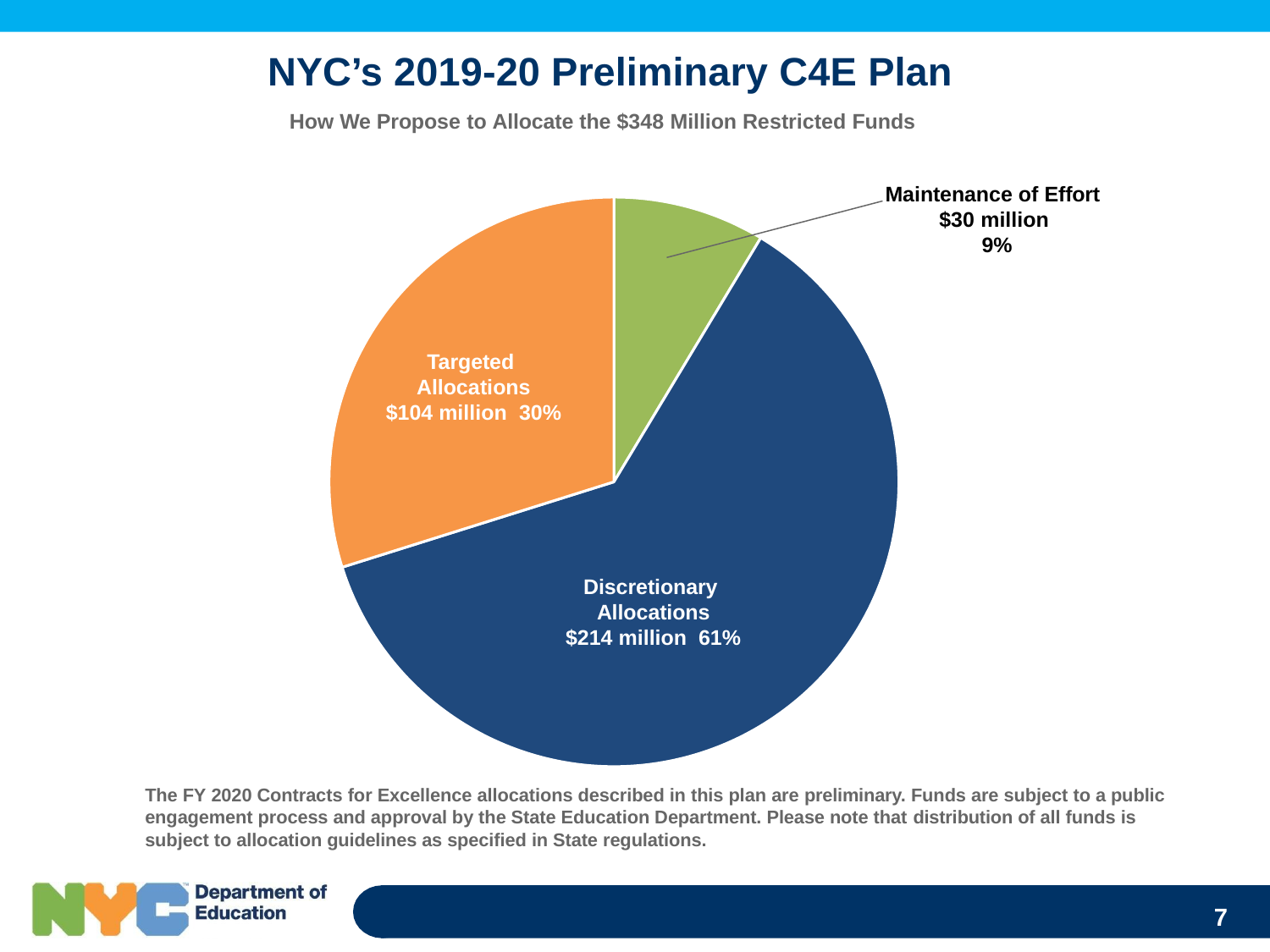
How many slices does the pie chart have? 3 What dollar amount is shown for Discretionary Allocations? $214 million What dollar amount is shown for Maintenance of Effort? $30 million Which is larger, Targeted Allocations or Maintenance of Effort? Targeted Allocations Which slice is the largest? Discretionary Allocations What share of the pie does Discretionary Allocations represent? 61% What kind of chart is shown on the slide? pie chart Which slice is the smallest? Maintenance of Effort What share of the pie does Maintenance of Effort represent? 9% What is the difference in dollars between Discretionary Allocations and Targeted Allocations? $110 million What dollar amount is shown for Targeted Allocations? $104 million What colour is the Maintenance of Effort slice? green